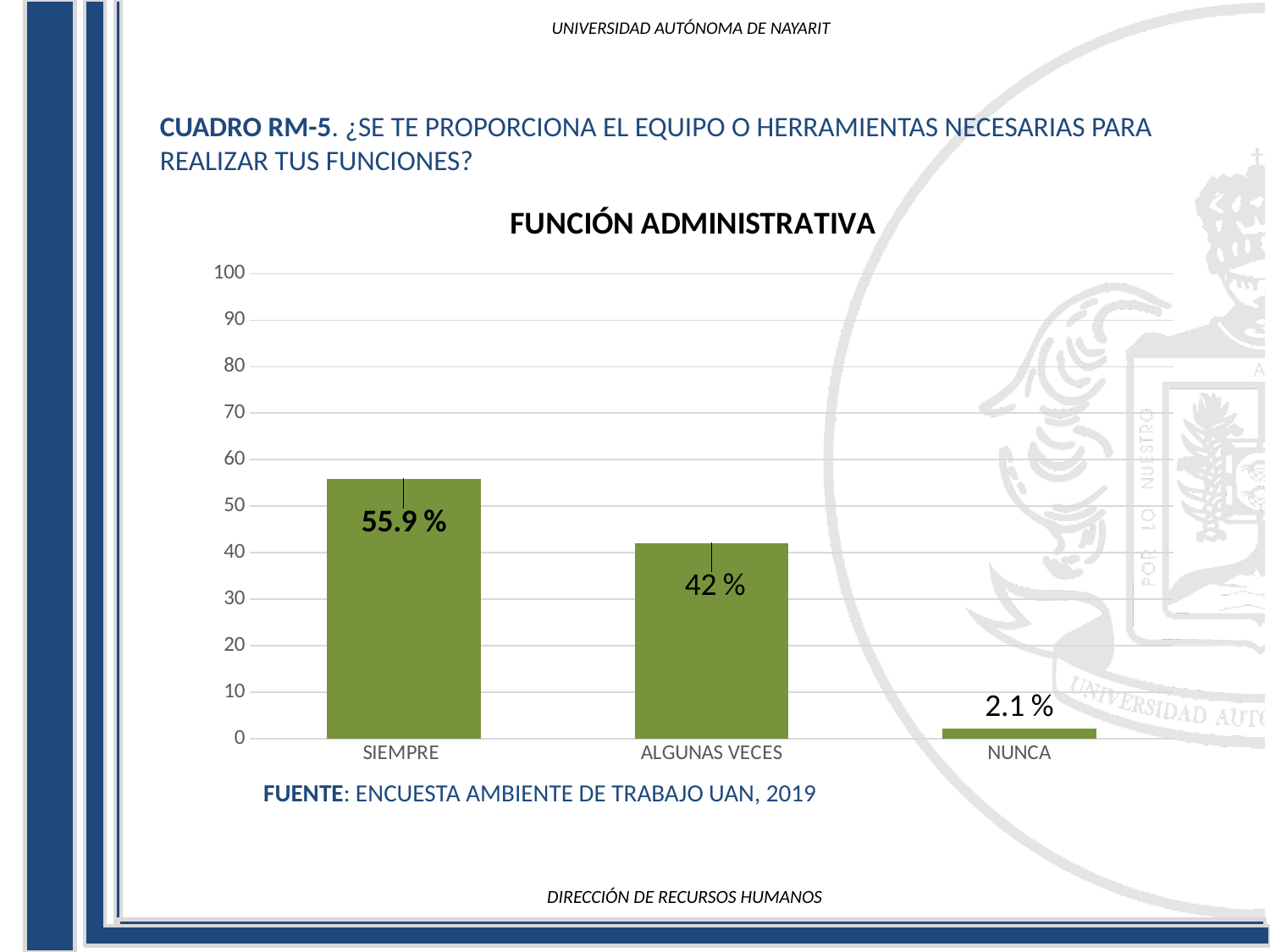
What is the value for NUNCA? 2.1 % Is the value for SIEMPRE greater or less than 50? greater How many categories are shown on the x axis? 3 What is the value for SIEMPRE? 55.9 % What is the value for ALGUNAS VECES? 42 % Which is larger, the value for ALGUNAS VECES or the value for NUNCA? ALGUNAS VECES Which category has the lowest value? NUNCA What is the difference between the values for SIEMPRE and ALGUNAS VECES? 13.9 % Is the value for NUNCA greater or less than 10? less What kind of chart is shown on the slide? bar chart Which category has the highest value? SIEMPRE What is the title of the chart? FUNCIÓN ADMINISTRATIVA